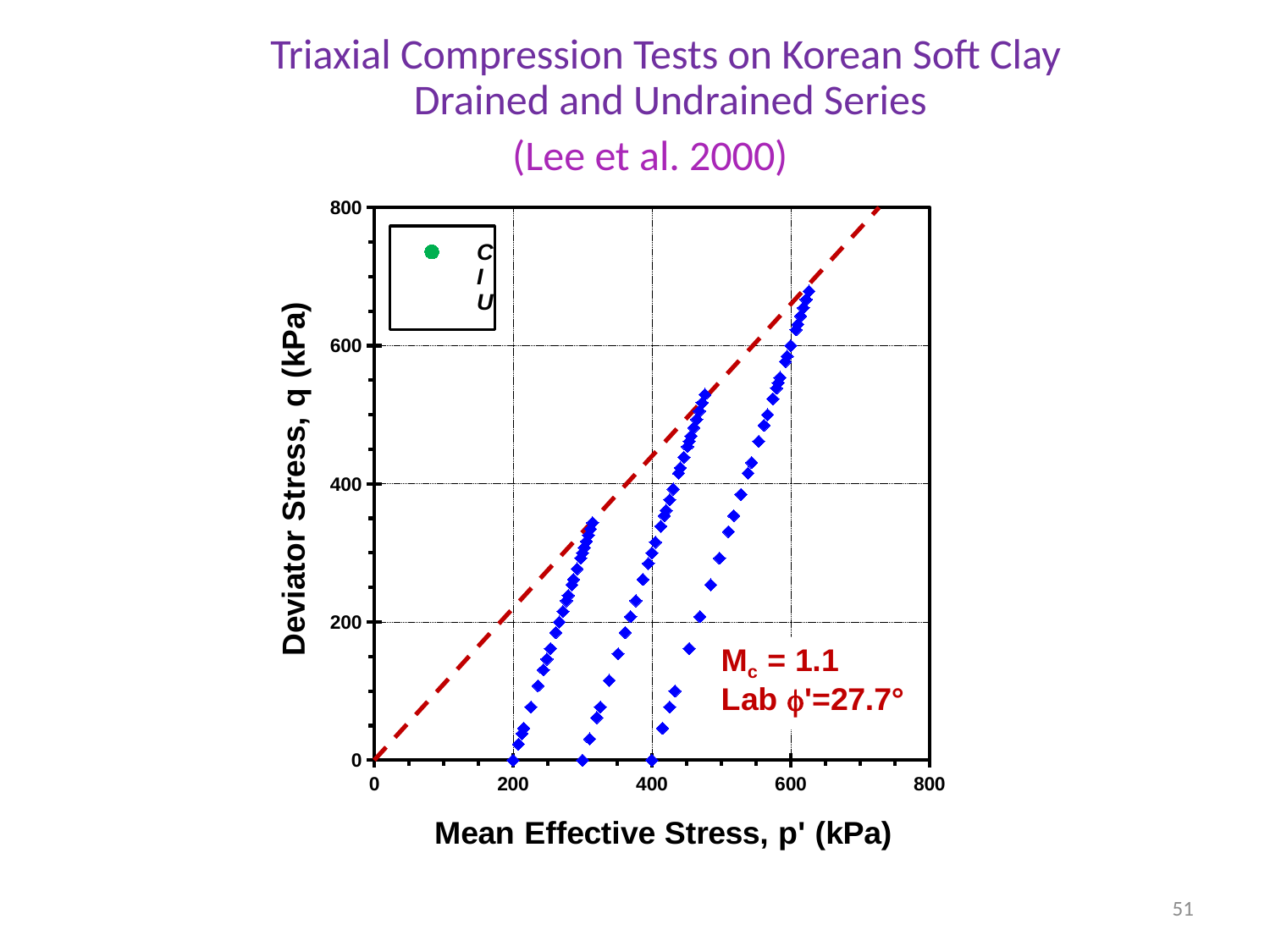
Is the peak deviator stress reached by the rightmost stress path greater or less than 600 kPa? greater What is the label of the y axis? Deviator Stress, q (kPa) Is the peak deviator stress reached by the leftmost stress path greater or less than 400 kPa? less Which stress path reaches the highest deviator stress: the one starting at p' = 200, 300 or 400 kPa? 400 kPa What lab friction angle φ' is printed on the chart? 27.7° How many entries does the legend list? 1 How many separate stress paths (series of blue points) are plotted on the chart? 3 What kind of chart is shown on the slide? scatter plot What is the label of the x axis? Mean Effective Stress, p' (kPa) At what mean effective stress p' does the rightmost stress path start on the x axis? 400 At what mean effective stress p' does the leftmost stress path start on the x axis? 200 What value of Mc is printed on the chart? 1.1